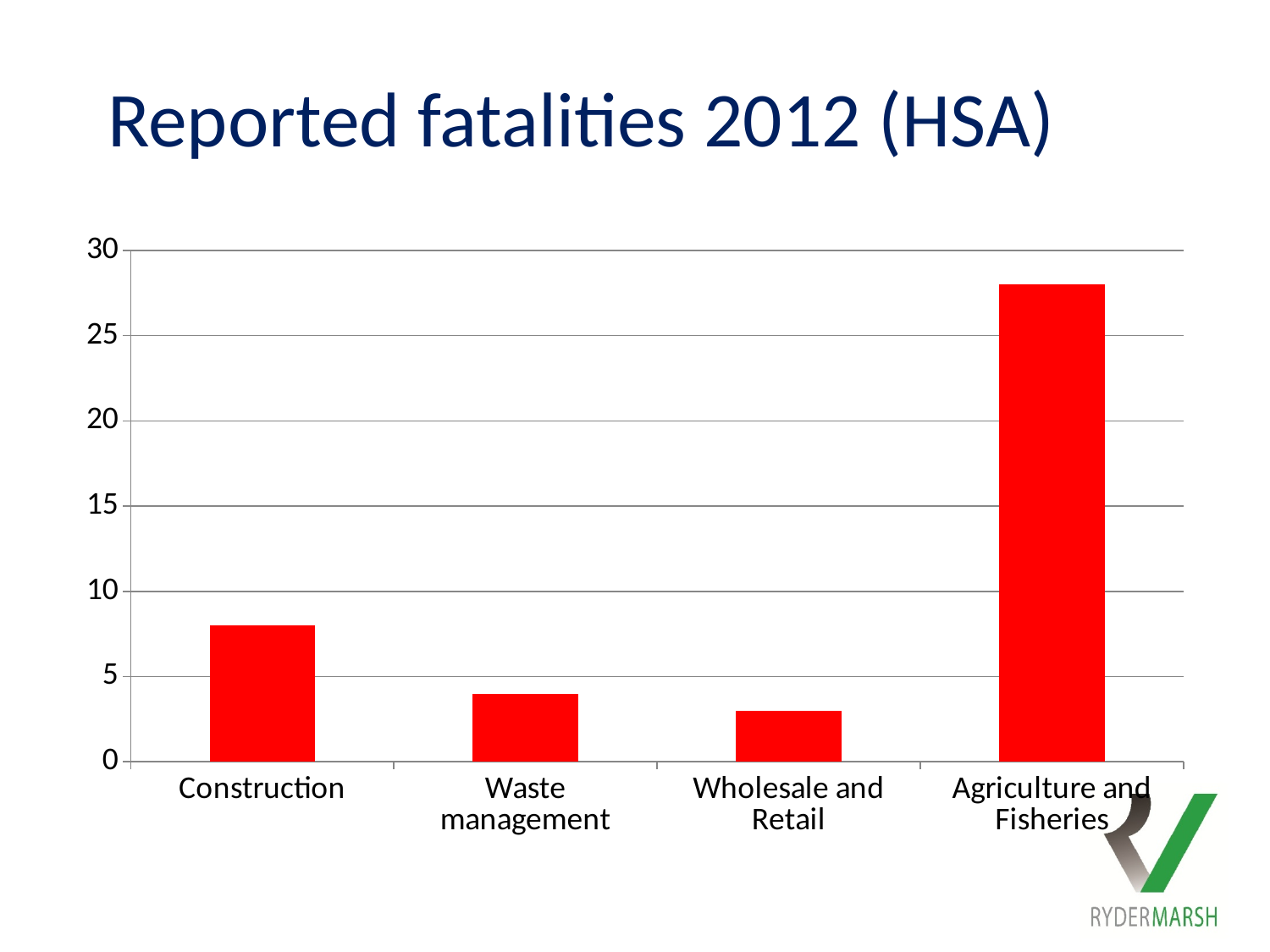
How many categories are shown on the x axis of the chart? 4 Which category has the lowest number of reported fatalities? Wholesale and Retail Is the value for Construction greater or less than 5? greater Is the value for Agriculture and Fisheries greater or less than 25? greater Which is larger, the value for Construction or the value for Waste management? Construction Which category has the highest number of reported fatalities? Agriculture and Fisheries Which is larger, the value for Wholesale and Retail or the value for Agriculture and Fisheries? Agriculture and Fisheries What is the title of the slide containing the chart? Reported fatalities 2012 (HSA) Is the value for Waste management greater or less than 5? less What type of chart is shown on the slide? bar chart